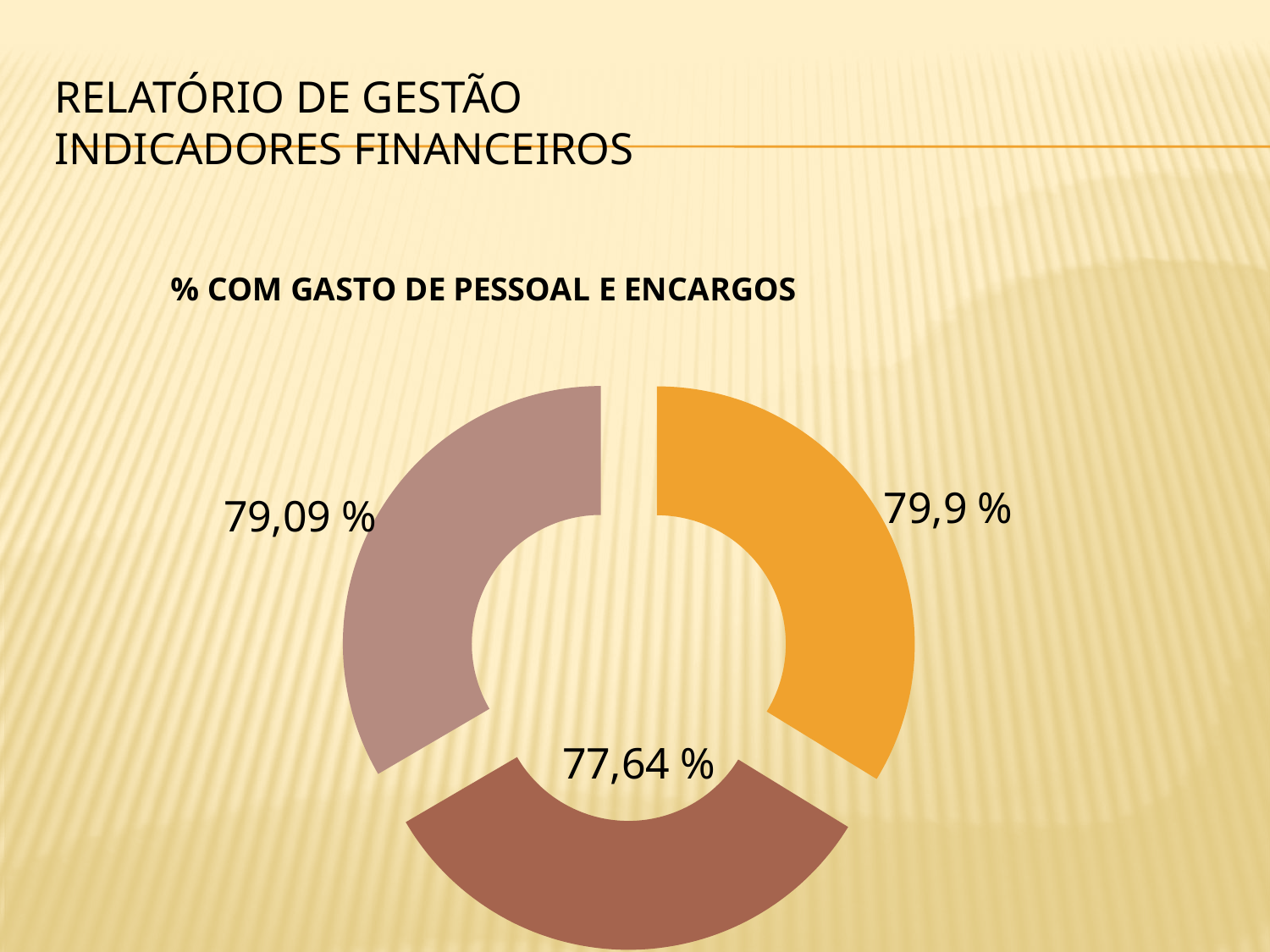
How many segments does the doughnut chart have? 3 Which labelled value in the doughnut chart is the lowest? 77,64 % Which labelled value in the doughnut chart is the highest? 79,9 % What is the difference between the highest labelled value (79,9 %) and the lowest labelled value (77,64 %) in the doughnut chart? 2,26 % What kind of chart is shown on the slide? Doughnut (pie) chart What colour is the segment labelled 77,64 % in the doughnut chart? Dark brown What is the title of the chart on the slide? % COM GASTO DE PESSOAL E ENCARGOS Which is larger: the value on the mauve segment or the value on the dark brown segment? The mauve segment (79,09 %) What value is labelled on the mauve (greyish-pink) segment on the left of the doughnut chart? 79,09 % What value is labelled on the orange segment of the doughnut chart? 79,9 % What value is labelled on the dark brown segment at the bottom of the doughnut chart? 77,64 % What is the difference between the orange segment's value (79,9 %) and the mauve segment's value (79,09 %)? 0,81 %